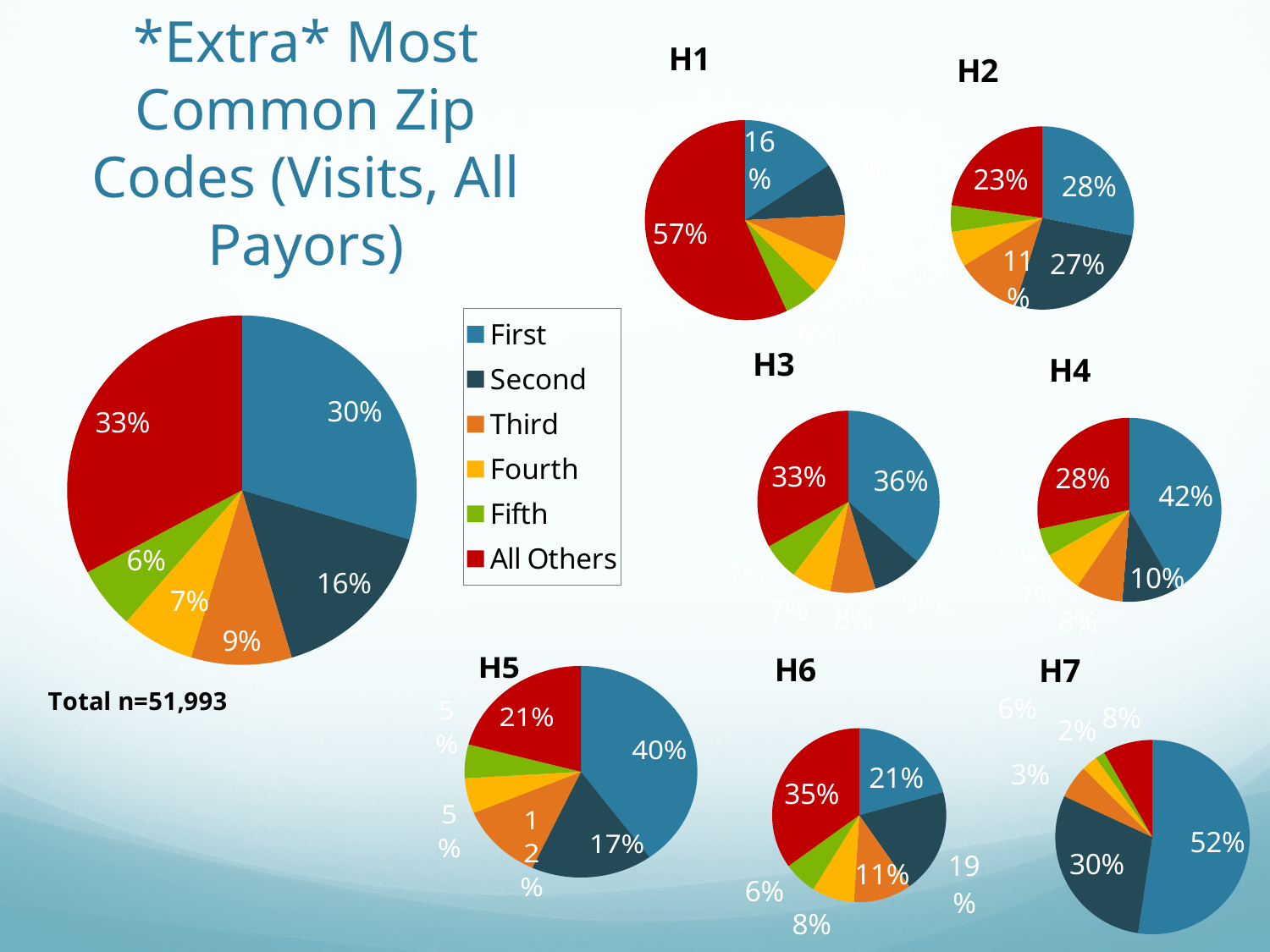
In the H2 pie chart, which is larger, the First share or the Second share? First What type of chart is used for H3? Pie chart In the H5 pie chart, what is the difference between the First and Second shares? 23% In the H1 pie chart, what share is labelled All Others? 57% In the H6 pie chart, what share is labelled All Others? 35% In the large pie chart on the left, what share of visits comes from the First zip code? 30% In the H4 pie chart, what share does the First zip code have? 42% How many entries does the legend list? 6 In the large pie chart on the left, what share is labelled All Others? 33% In the H7 pie chart, which category has the largest share? First In the large pie chart on the left, which category has the smallest share? Fifth In the large pie chart on the left, what is the difference between the Second and Third shares? 7%